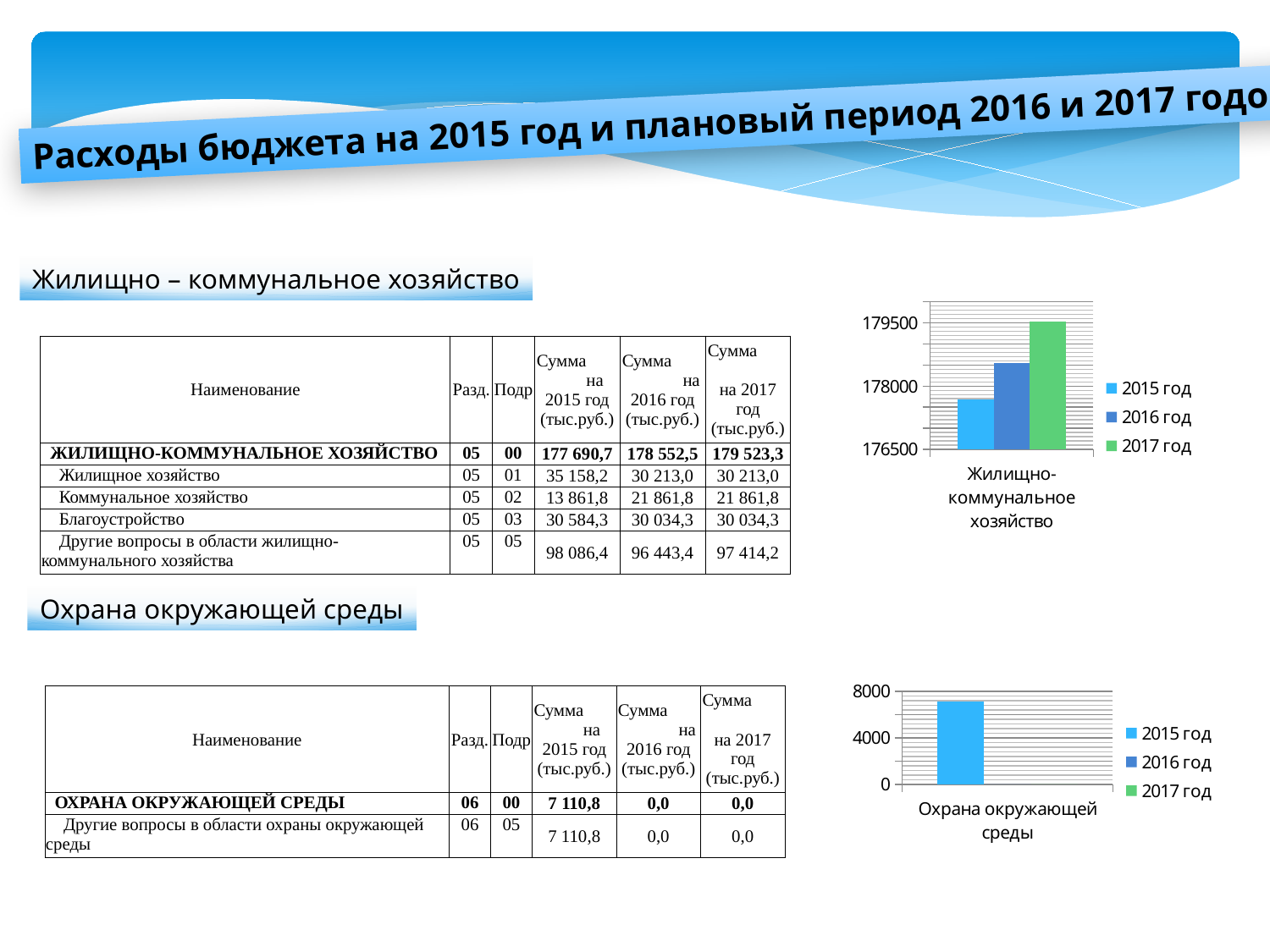
In the top chart (Жилищно-коммунальное хозяйство), which year has the tallest bar? 2017 год In the top chart (Жилищно-коммунальное хозяйство), which year has the shortest bar? 2015 год In the top chart (Жилищно-коммунальное хозяйство), what kind of chart is shown? bar chart In the top chart (Жилищно-коммунальное хозяйство), do the bars rise or fall from 2015 год to 2017 год? rise In the top chart (Жилищно-коммунальное хозяйство), which is larger, the bar for 2015 год or the bar for 2016 год? 2016 год In the top chart (Жилищно-коммунальное хозяйство), how many series does the legend list? 3 In the top chart (Жилищно-коммунальное хозяйство), is the value for 2015 год greater or less than 178000? less In the top chart (Жилищно-коммунальное хозяйство), is the value for 2016 год greater or less than 178000? greater In the bottom chart (Охрана окружающей среды), which year has the tallest bar? 2015 год In the bottom chart (Охрана окружающей среды), what kind of chart is shown? bar chart In the bottom chart (Охрана окружающей среды), is the value for 2015 год greater or less than 4000? greater In the top chart (Жилищно-коммунальное хозяйство), how many categories are shown on the x axis? 1